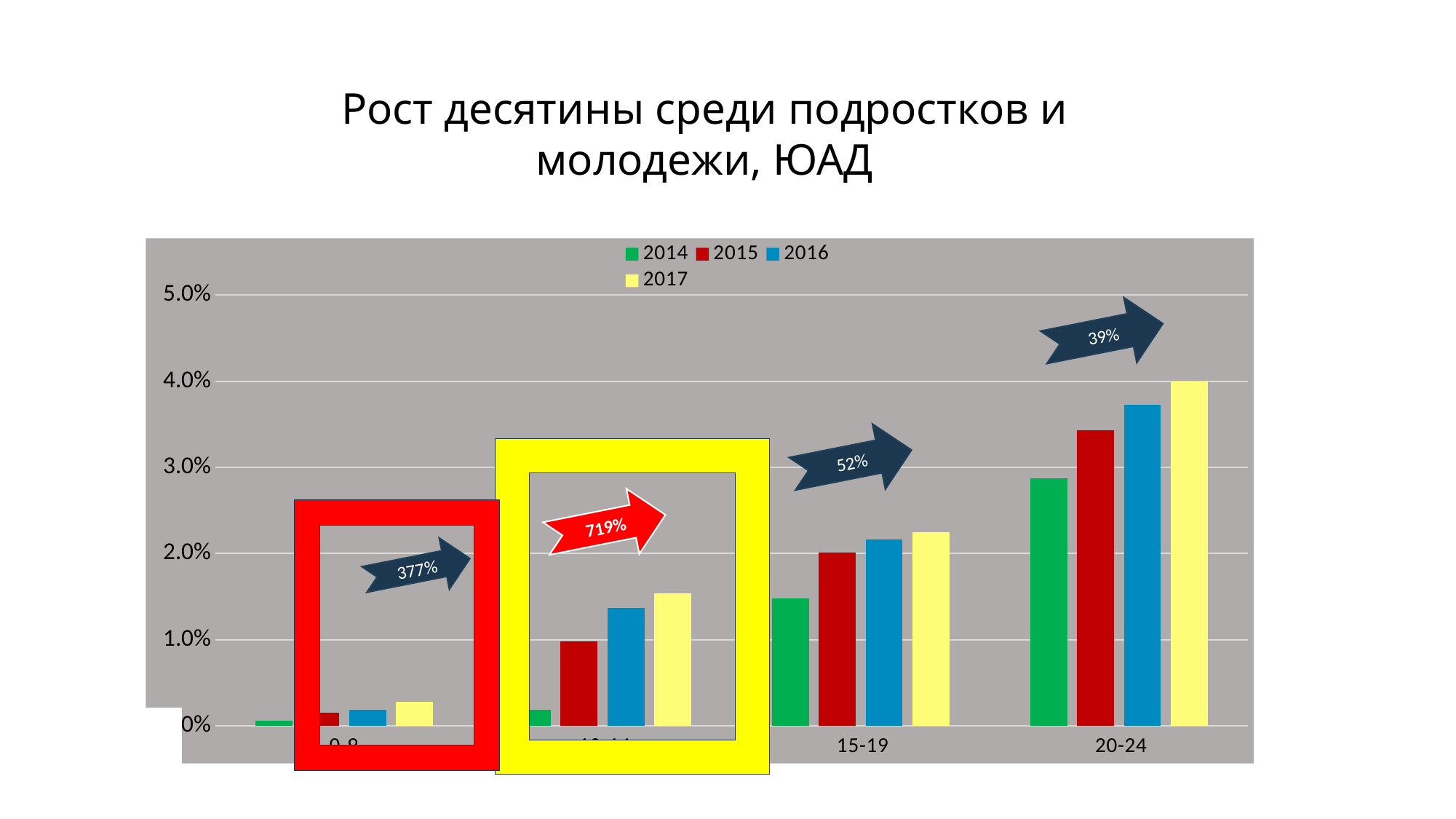
What kind of chart is shown on the slide? bar chart Within the 15-19 age group, do the values rise or fall from 2014 to 2017? rise How many age-group categories are plotted along the x axis? 4 Within the 20-24 age group, which year has the highest value? 2017 Which is larger: the 2016 value for 15-19 or the 2016 value for 20-24? 20-24 Is the value for 2014 in the 15-19 age group greater or less than 1.0%? greater What percentage is written on the arrow above the 15-19 age group? 52% Which age group has the highest value for 2017? 20-24 Is the value for 2016 in the 20-24 age group greater or less than 3.0%? greater How many series does the legend list? 4 Within the 15-19 age group, which year has the lowest value? 2014 Is the value for 2017 in the 15-19 age group greater or less than 2.0%? greater